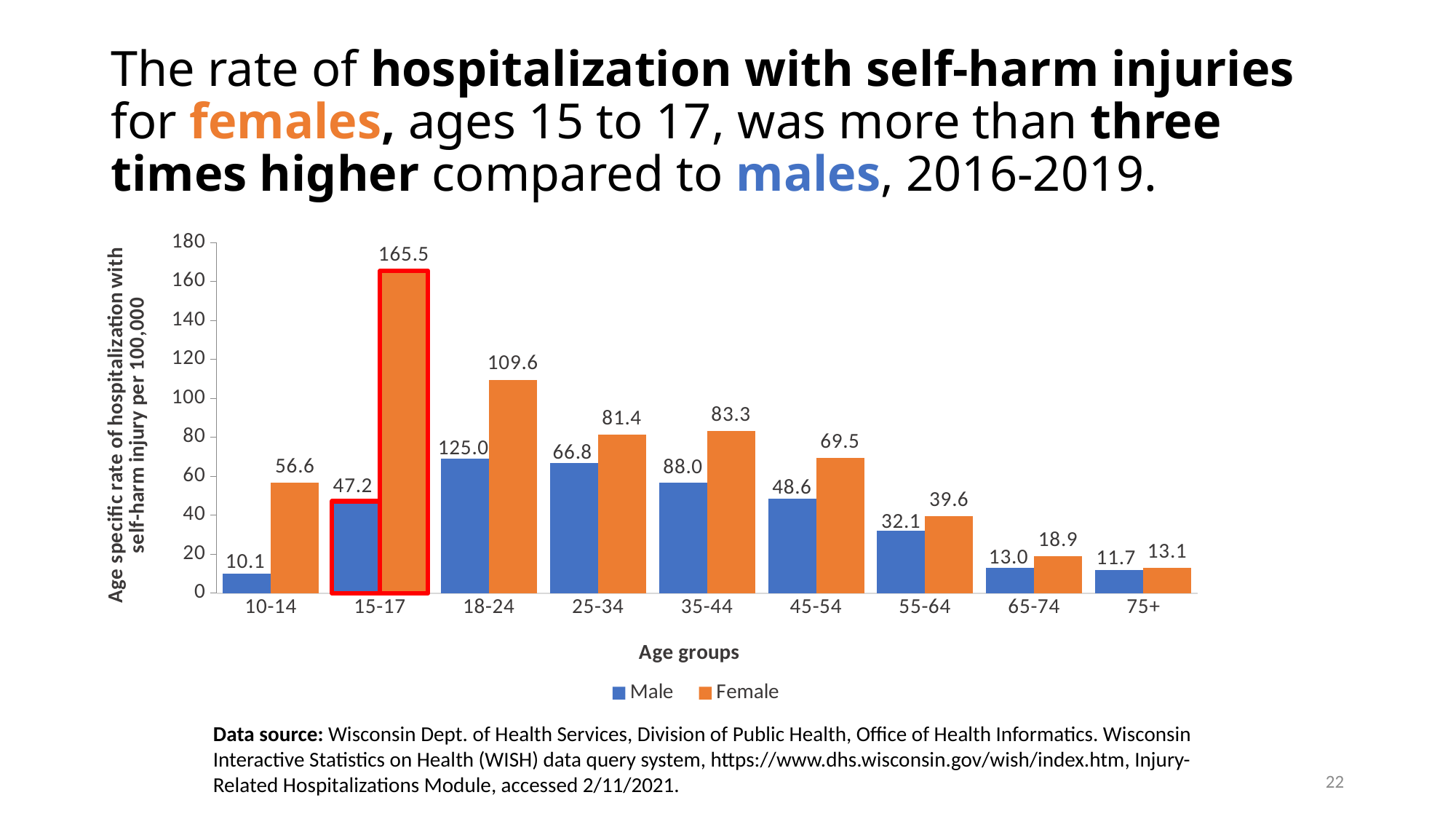
Which age group has the lowest male rate? 10-14 What kind of chart is shown on the slide? Bar chart Which age group has the highest female rate? 15-17 What is the difference between the female and male rates for the 15-17 age group? 118.3 What is the female rate for the 15-17 age group? 165.5 Is the female value for the 18-24 age group greater or less than 100? greater What is the male rate for the 55-64 age group? 32.1 What is the male rate for the 15-17 age group? 47.2 Which is larger for the 45-54 age group, the male rate or the female rate? Female How many age groups are shown on the x axis? 9 What is the female rate for the 10-14 age group? 56.6 How many series does the legend list? 2